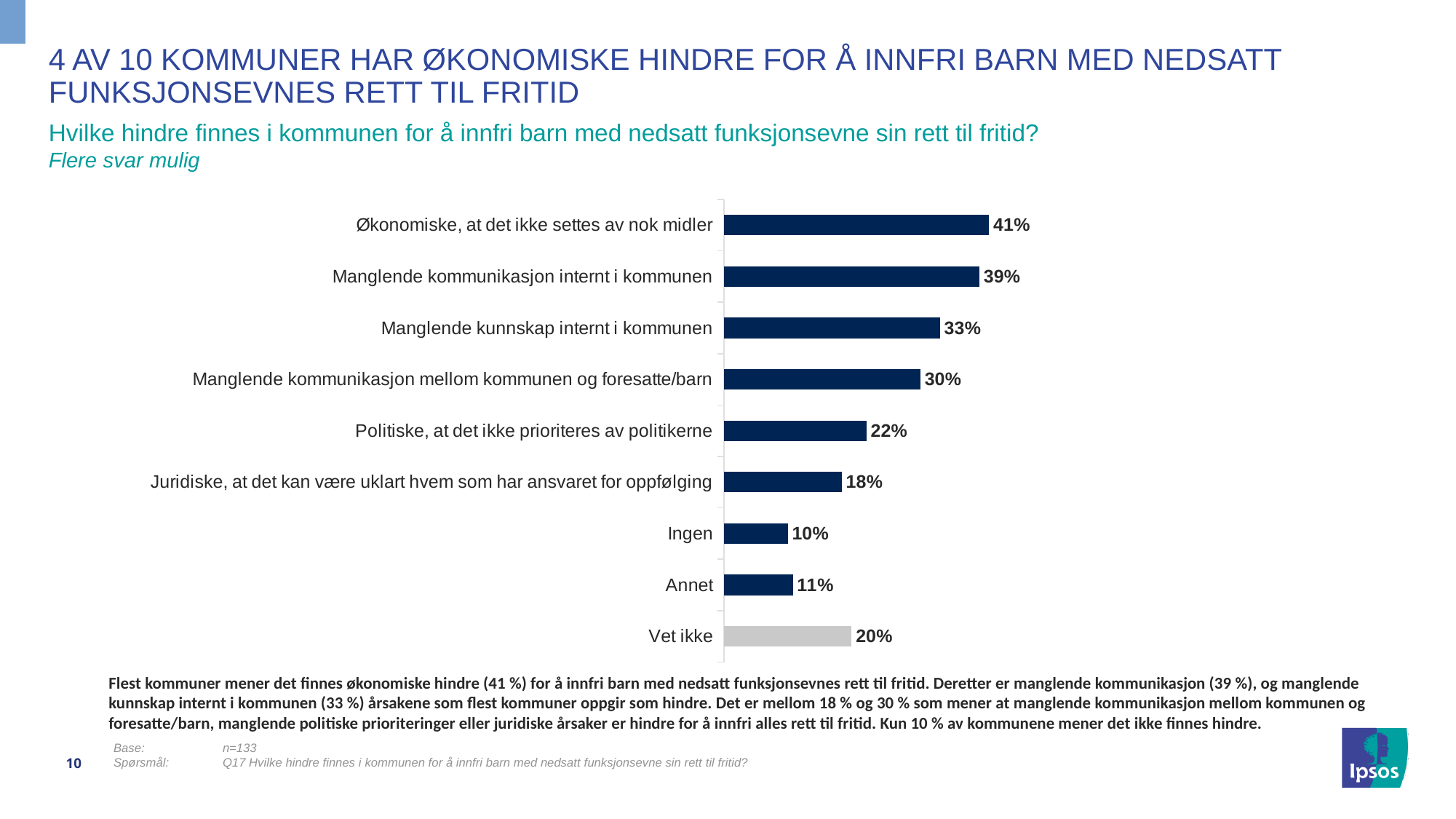
What is the difference between "Manglende kommunikasjon mellom kommunen og foresatte/barn" and "Vet ikke"? 10% Which bar is shown in a different colour (grey) from the others? Vet ikke What is the value for "Vet ikke"? 20% What is the value for "Økonomiske, at det ikke settes av nok midler"? 41% Which category has the highest value? Økonomiske, at det ikke settes av nok midler What is the value for "Manglende kunnskap internt i kommunen"? 33% How many categories are shown in the chart? 9 What is the value for "Ingen"? 10% Which category has the lowest value? Ingen What is the difference between "Manglende kommunikasjon internt i kommunen" and "Politiske, at det ikke prioriteres av politikerne"? 17% Which is larger: "Juridiske, at det kan være uklart hvem som har ansvaret for oppfølging" or "Annet"? Juridiske, at det kan være uklart hvem som har ansvaret for oppfølging What kind of chart is shown on the slide? Bar chart